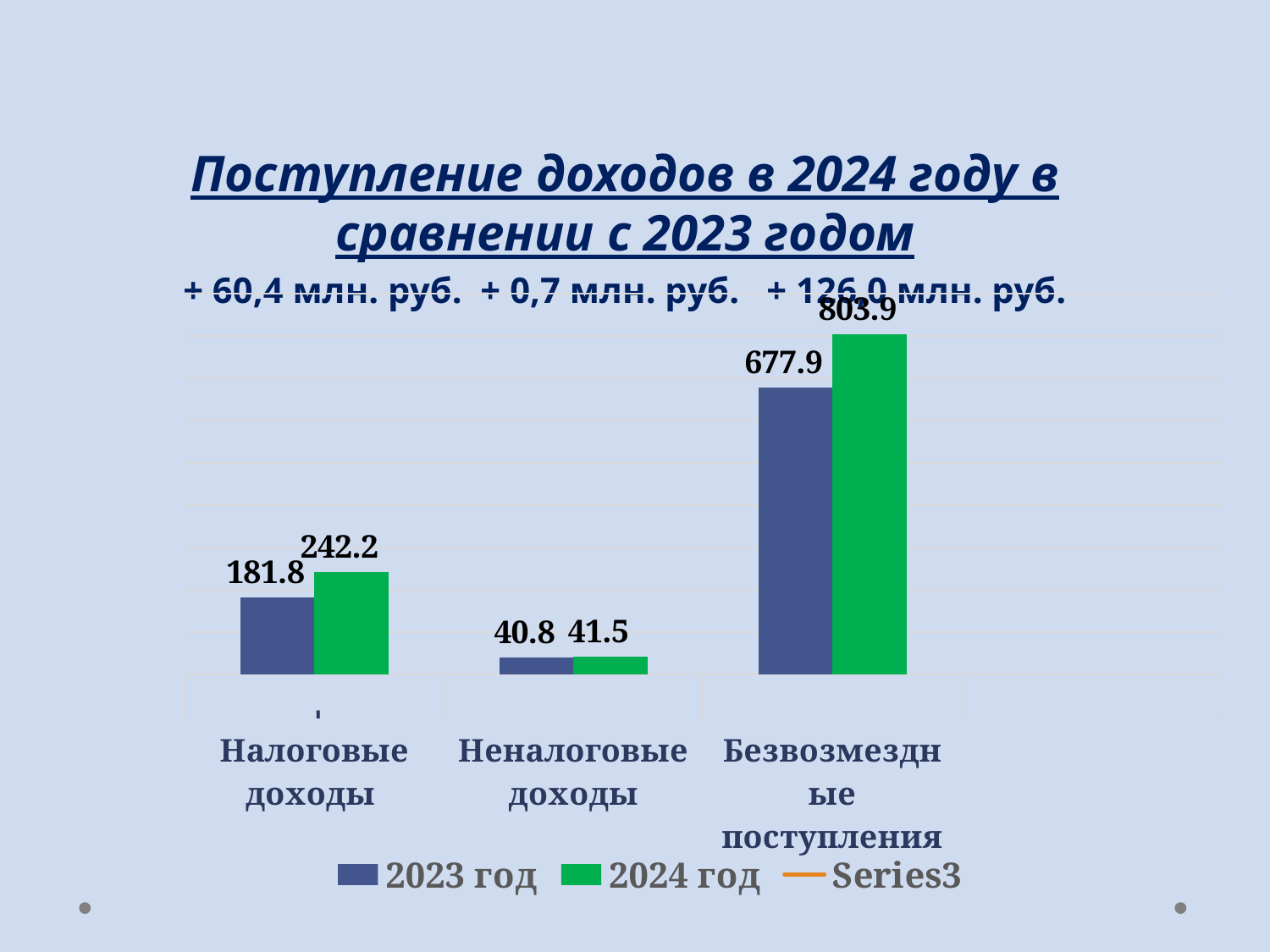
Which category has the highest value in the 2024 год series? Безвозмездные поступления What is the value for Неналоговые доходы in the 2023 год series? 40.8 How many series does the legend list? 3 What is the difference between the 2024 год and 2023 год values for Безвозмездные поступления? 126.0 What is the value for Налоговые доходы in the 2023 год series? 181.8 What is the value for Налоговые доходы in the 2024 год series? 242.2 Which is larger for Неналоговые доходы: the 2023 год value or the 2024 год value? 2024 год Which category has the lowest value in the 2023 год series? Неналоговые доходы How many categories are shown on the x axis? 3 What is the difference between the 2024 год and 2023 год values for Налоговые доходы? 60.4 What is the value for Безвозмездные поступления in the 2024 год series? 803.9 What type of chart is shown on the slide? Bar chart